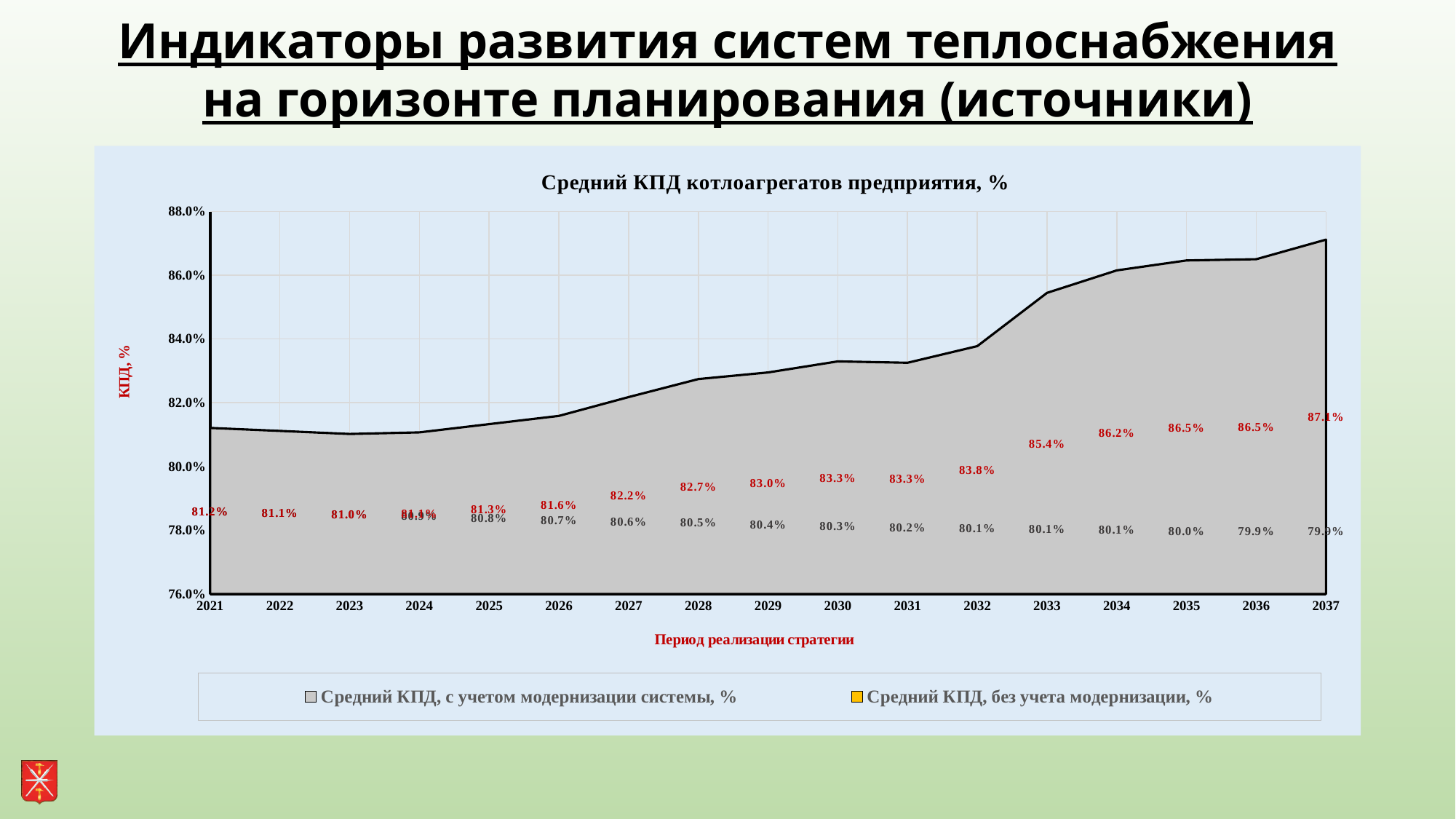
Which is larger in 2033: the value with modernization (с учетом модернизации) or without modernization (без учета модернизации)? с учетом модернизации (85.4%) What is the difference between the 2037 and 2021 values of the series 'Средний КПД, с учетом модернизации системы, %'? 5.9% What kind of chart is shown on the slide? Area chart What is the value of the series 'Средний КПД, без учета модернизации, %' for 2036? 79.9% What is the value of the series 'Средний КПД, без учета модернизации, %' for 2030? 80.3% Does the series 'Средний КПД, без учета модернизации, %' rise or fall from 2024 to 2037? Fall What is the value of the series 'Средний КПД, с учетом модернизации системы, %' for 2028? 82.7% What is the value of the series 'Средний КПД, с учетом модернизации системы, %' for 2037? 87.1% How many series does the legend list? 2 How many years are shown on the x axis of the chart? 17 In which year does the series 'Средний КПД, с учетом модернизации системы, %' reach its highest value? 2037 In which year is the series 'Средний КПД, с учетом модернизации системы, %' at its lowest value? 2023